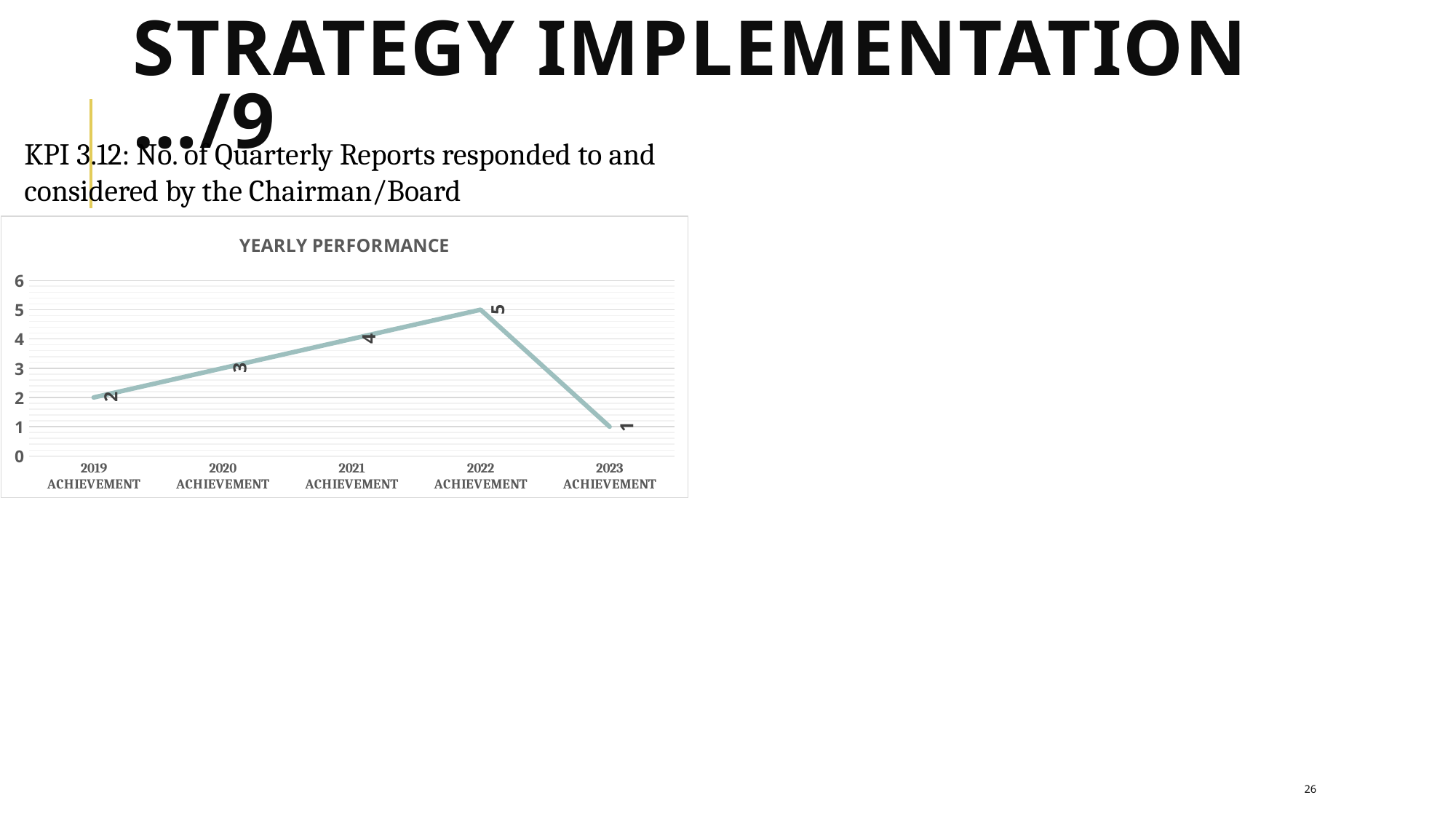
What is the difference between the values for 2022 ACHIEVEMENT and 2023 ACHIEVEMENT? 4 Do the values rise or fall from 2019 to 2022? rise What kind of chart is shown? line chart Is the value for 2021 ACHIEVEMENT greater or less than 3? greater What is the title of the chart? YEARLY PERFORMANCE What is the value for 2023 ACHIEVEMENT? 1 Which year has the highest value? 2022 ACHIEVEMENT What is the value for 2019 ACHIEVEMENT? 2 What is the value for 2022 ACHIEVEMENT? 5 How many data points are plotted on the chart? 5 Which is larger, the value for 2021 ACHIEVEMENT or 2020 ACHIEVEMENT? 2021 ACHIEVEMENT Which year has the lowest value? 2023 ACHIEVEMENT